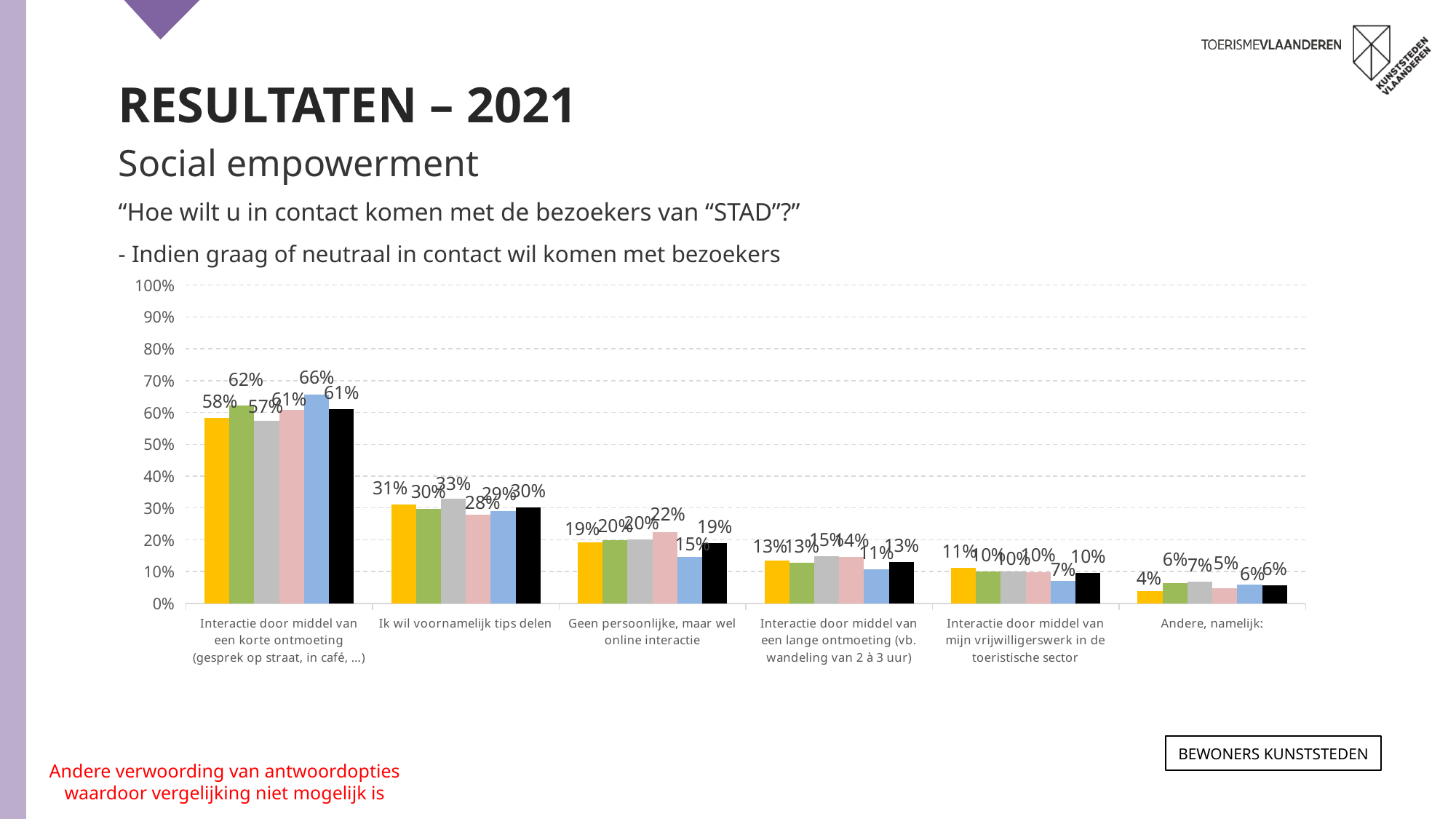
Which is larger for "Interactie door middel van mijn vrijwilligerswerk in de toeristische sector": the yellow bar or the blue bar? the yellow bar What is the value of the yellow bar for "Interactie door middel van een korte ontmoeting (gesprek op straat, in café, …)"? 58% How many categories are shown along the x axis of the chart? 6 Do the values generally rise or fall moving from left to right across the categories? fall What is the value of the grey bar for "Ik wil voornamelijk tips delen"? 33% Which category has the lowest values overall in the chart? Andere, namelijk: What is the value of the blue bar for "Geen persoonlijke, maar wel online interactie"? 15% What kind of chart is shown on the slide? bar chart Which category has the highest values overall in the chart? Interactie door middel van een korte ontmoeting (gesprek op straat, in café, …) What is the value of the blue bar for "Interactie door middel van een korte ontmoeting (gesprek op straat, in café, …)"? 66% What is the value of the yellow bar for "Andere, namelijk:"? 4% What is the difference between the blue bar (66%) and the grey bar (57%) for "Interactie door middel van een korte ontmoeting (gesprek op straat, in café, …)"? 9%